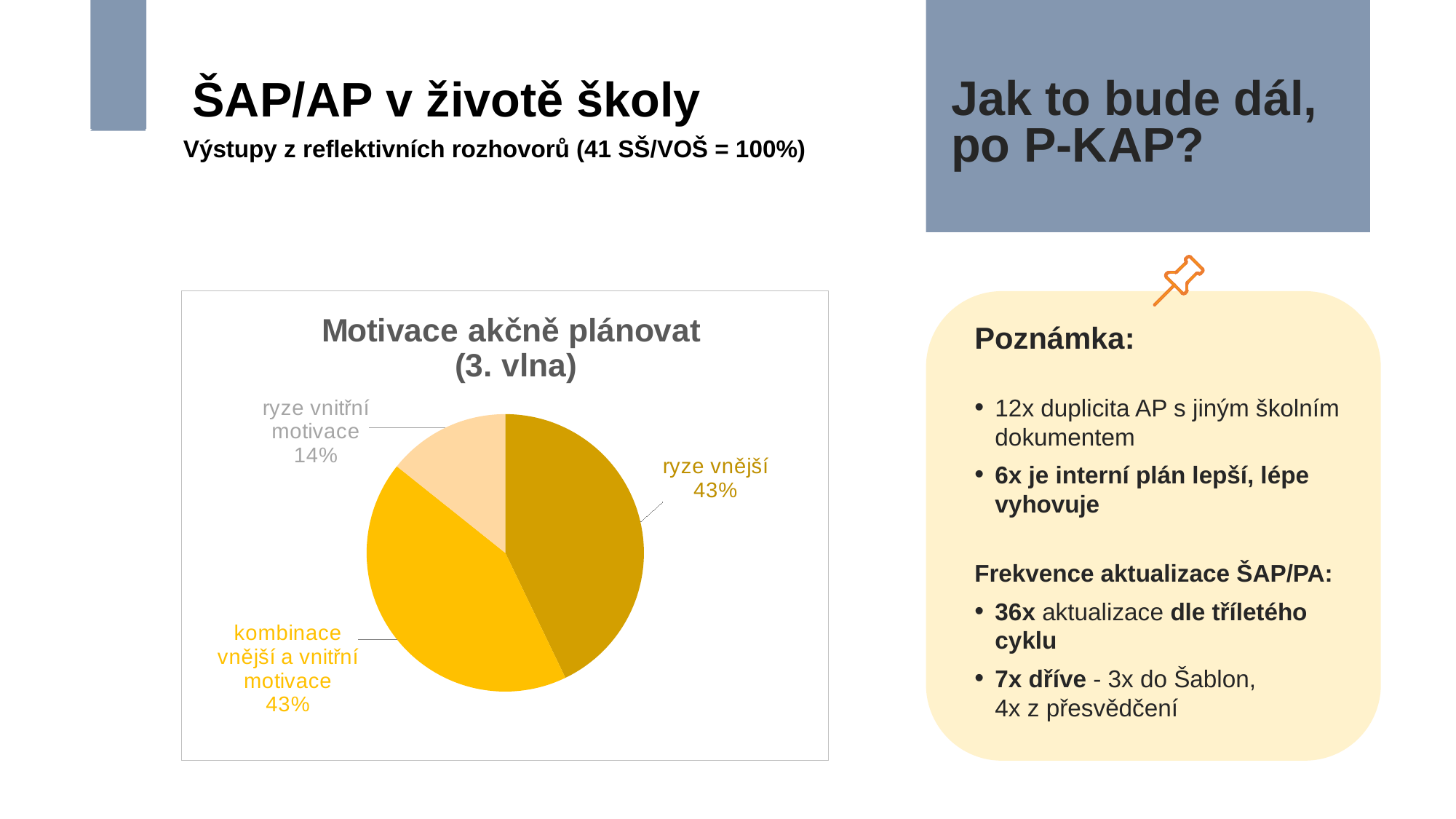
Which slice of the pie chart is the smallest? ryze vnitřní motivace Is the share for "ryze vnitřní motivace" greater or less than 20%? less What is the combined share of the "ryze vnější" and "kombinace vnější a vnitřní motivace" slices? 86% How many slices does the pie chart have? 3 What is the title of the chart? Motivace akčně plánovat (3. vlna) Which two slices of the pie chart have the same share? ryze vnější and kombinace vnější a vnitřní motivace By how many percentage points does "ryze vnější" exceed "ryze vnitřní motivace"? 29 percentage points What share of the pie is labelled "kombinace vnější a vnitřní motivace"? 43% What share of the pie is labelled "ryze vnitřní motivace"? 14% What share of the pie is labelled "ryze vnější"? 43% What kind of chart is shown on the slide? pie chart Which is larger, the "ryze vnější" slice or the "ryze vnitřní motivace" slice? ryze vnější